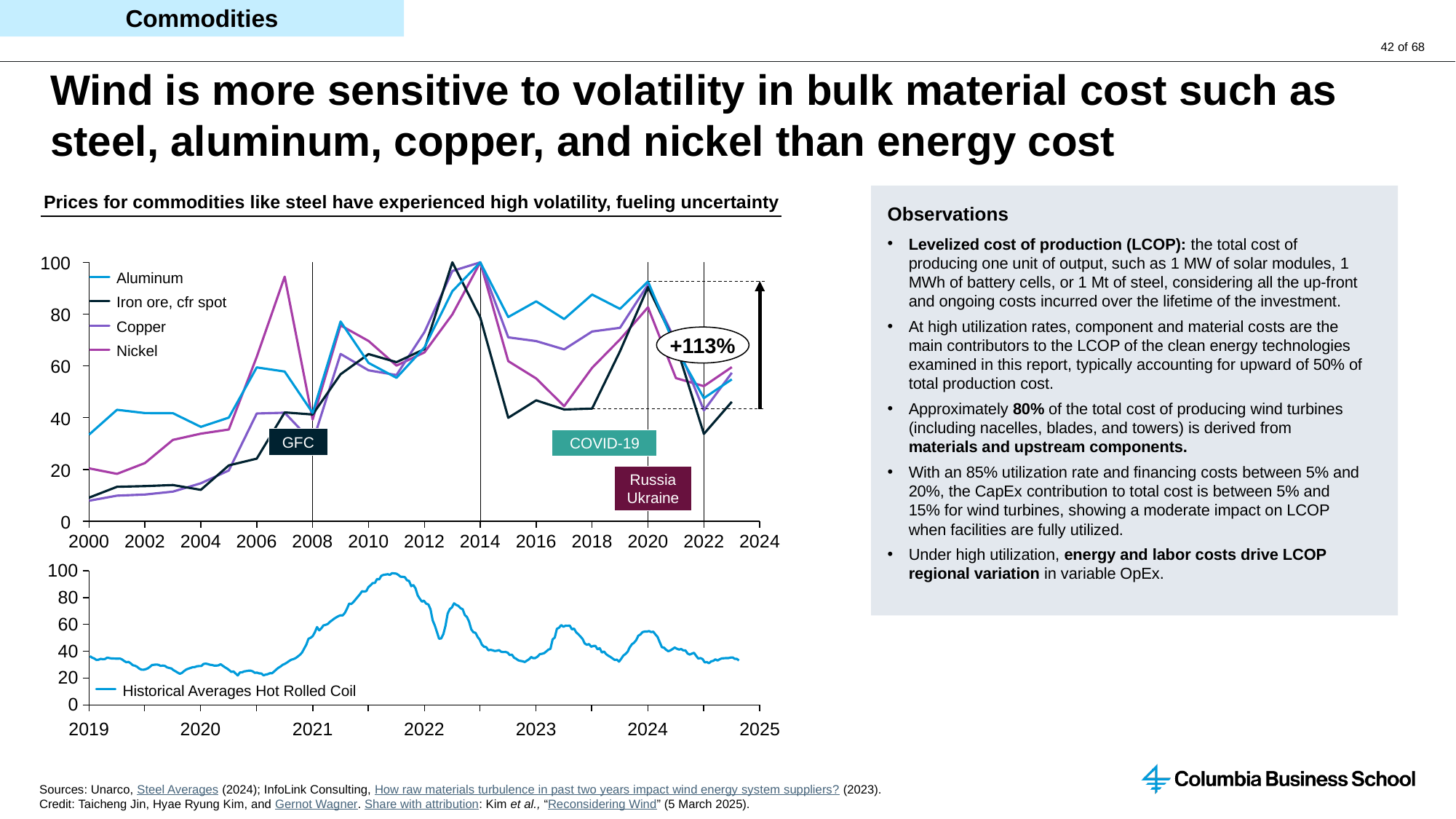
In the bottom chart, is the value for Historical Averages Hot Rolled Coil at the start of 2019 greater or less than 60? less What percentage change is printed in the annotation on the top chart? +113% In the top chart, which is larger in 2007: Nickel or Iron ore, cfr spot? Nickel In the bottom chart, does the Historical Averages Hot Rolled Coil line rise or fall from 2019 to its peak in late 2021? Rise How many series does the legend of the bottom chart list? 1 In the top chart, is the value for Aluminum in 2006 greater or less than 40? greater What kind of chart is the top chart showing Aluminum, Iron ore, Copper and Nickel? Line chart In the top chart, which series is highest in 2007? Nickel In the top chart, is the value for Iron ore, cfr spot in 2000 greater or less than 20? less How many series does the legend of the top chart list? 4 In the top chart, which series is lowest in 2015? Iron ore, cfr spot